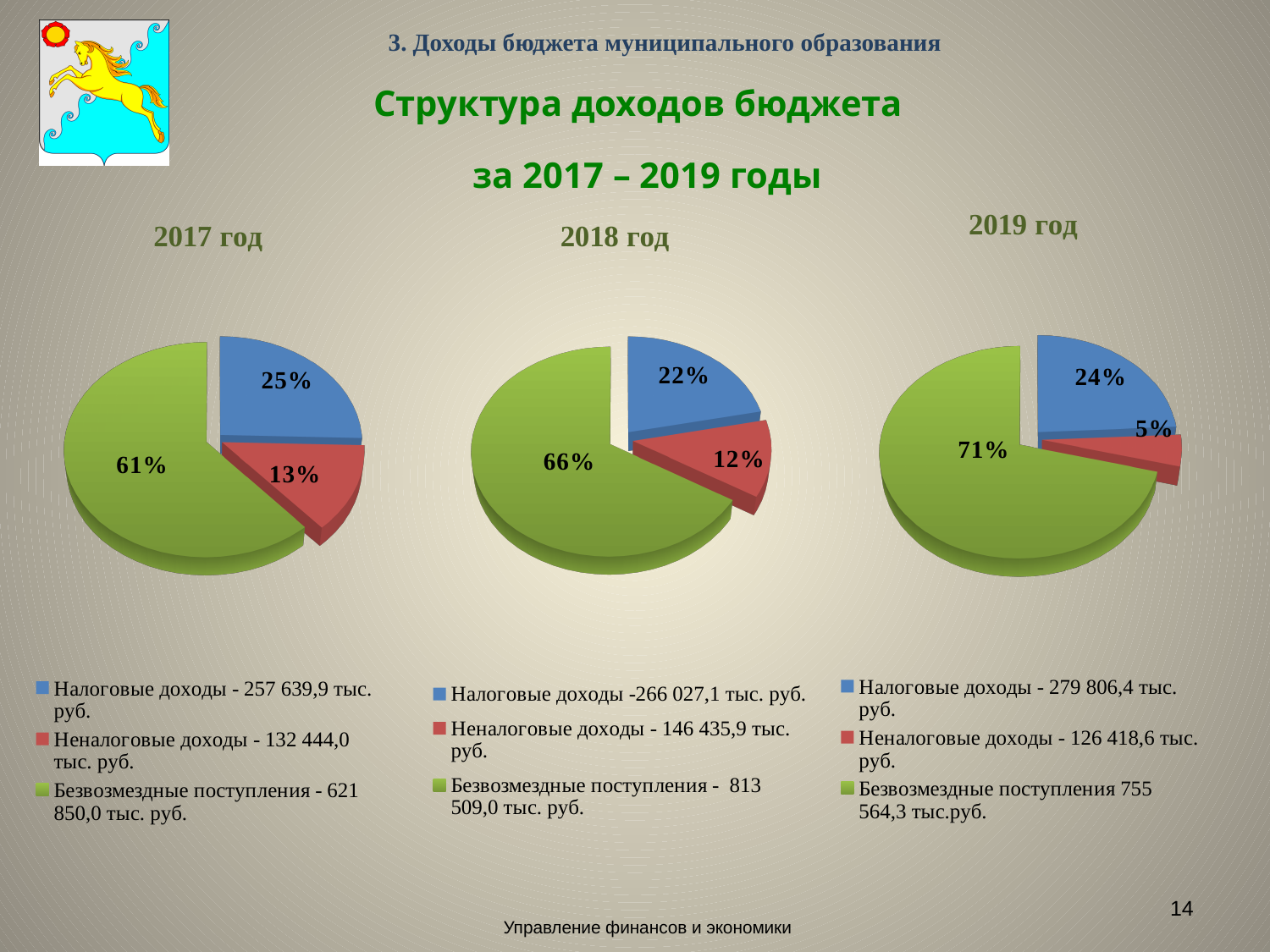
On the 2019 год chart, which is larger: the slice for Налоговые доходы or the slice for Неналоговые доходы? Налоговые доходы What kind of chart is used for 2017 год? Pie chart How many slices does the 2018 год chart have? 3 On the 2017 год chart, what share of the pie is Безвозмездные поступления? 61% On the 2018 год chart, what share of the pie is Налоговые доходы? 22% On the 2019 год chart, which category has the largest slice? Безвозмездные поступления On the 2019 год chart, what share of the pie is Неналоговые доходы? 5% On the 2017 год chart, what is the difference in percentage points between Налоговые доходы and Неналоговые доходы? 12 According to the legend of the 2019 год chart, what is the amount of Безвозмездные поступления? 755 564,3 тыс.руб. What colour represents Неналоговые доходы on the pie charts? Red According to the legend of the 2017 год chart, what is the amount of Налоговые доходы? 257 639,9 тыс. руб. On the 2018 год chart, which category has the smallest slice? Неналоговые доходы